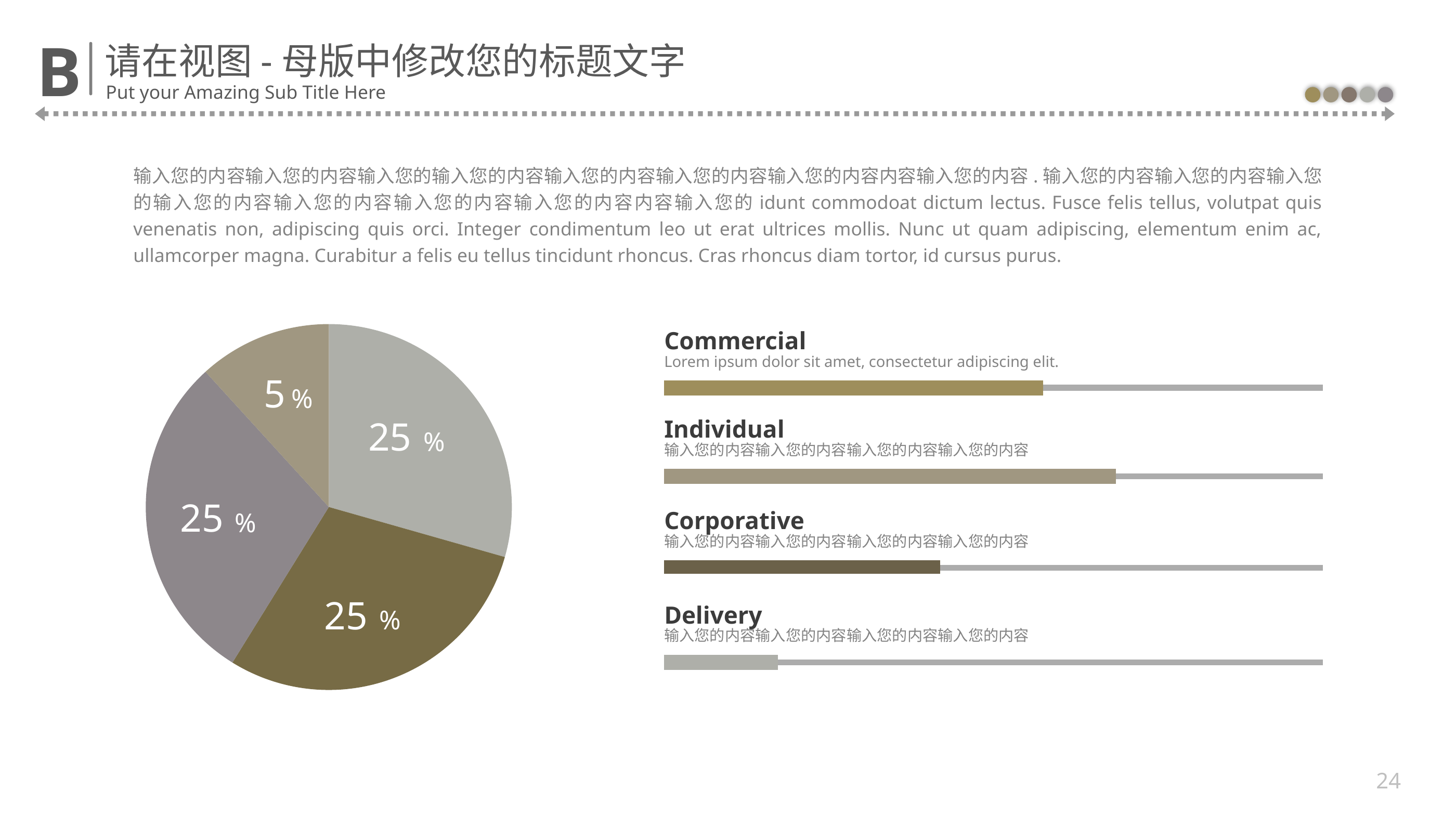
Which category on the right of the slide has the shortest filled progress bar? Delivery Is the slice labeled 5% larger or smaller than the slice labeled 25% on the left of the pie chart? smaller What kind of chart is shown on the left of the slide? pie chart What is the difference between the 25% slice and the 5% slice in the pie chart? 20% What value is labeled on the dark olive slice at the bottom of the pie chart? 25% How many slices of the pie chart are labeled 25%? 3 How many slices does the pie chart have? 4 What value is labeled on the small taupe slice at the top of the pie chart? 5% What is the smallest value labeled on the pie chart? 5% How many category headings are listed to the right of the pie chart? 4 What value is labeled on the light gray slice on the right side of the pie chart? 25%